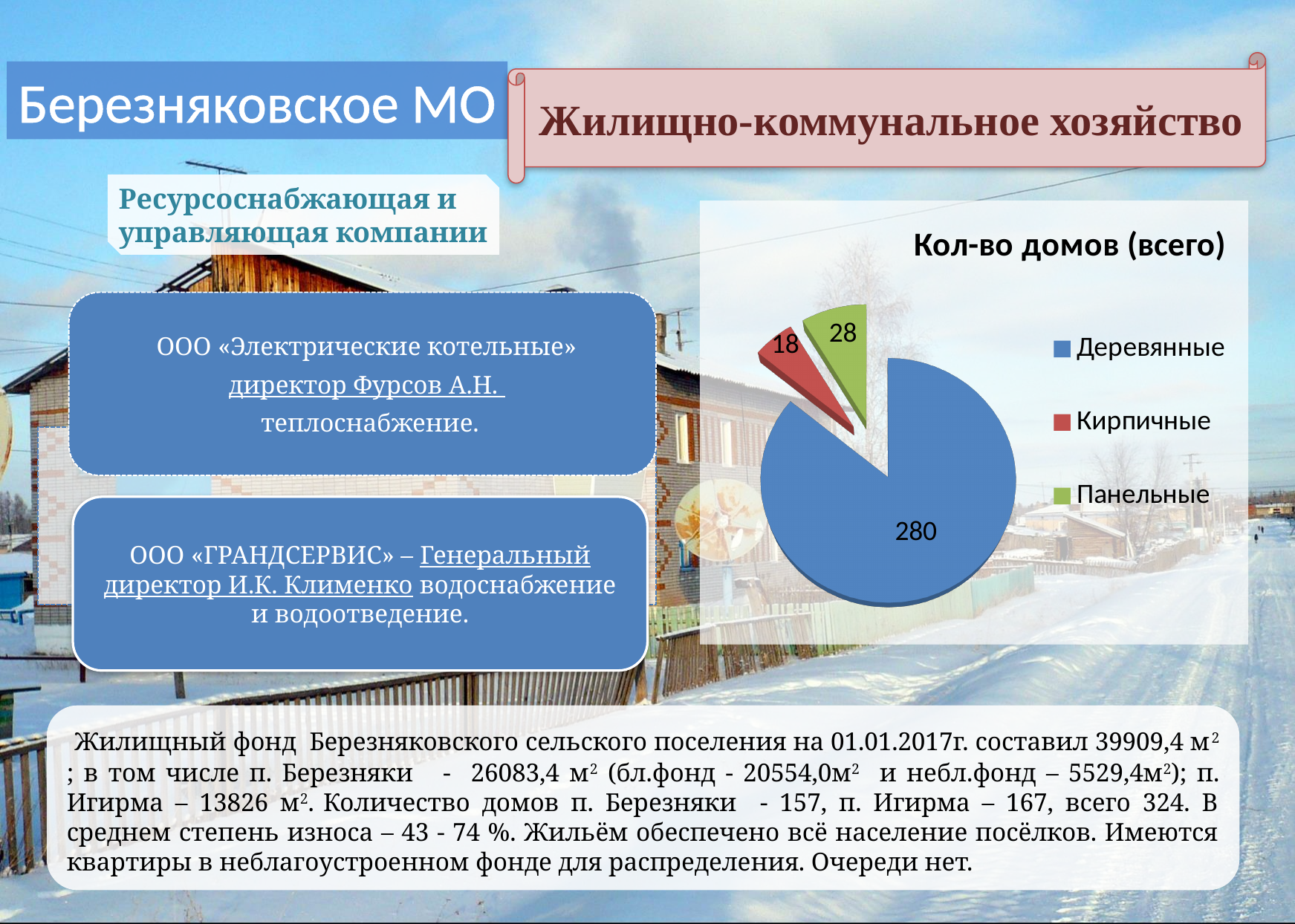
Which is larger, Панельные or Кирпичные? Панельные What type of chart is shown on the slide? pie chart How many slices does the pie chart have? 3 What is the value for Кирпичные in the pie chart? 18 How many entries does the chart legend list? 3 What is the difference between the values for Деревянные and Панельные? 252 Which category has the largest slice in the pie chart? Деревянные What colour is the Деревянные slice in the pie chart? blue What is the value for Деревянные in the pie chart? 280 What is the title of the chart? Кол-во домов (всего) What is the value for Панельные in the pie chart? 28 Which category has the smallest slice in the pie chart? Кирпичные